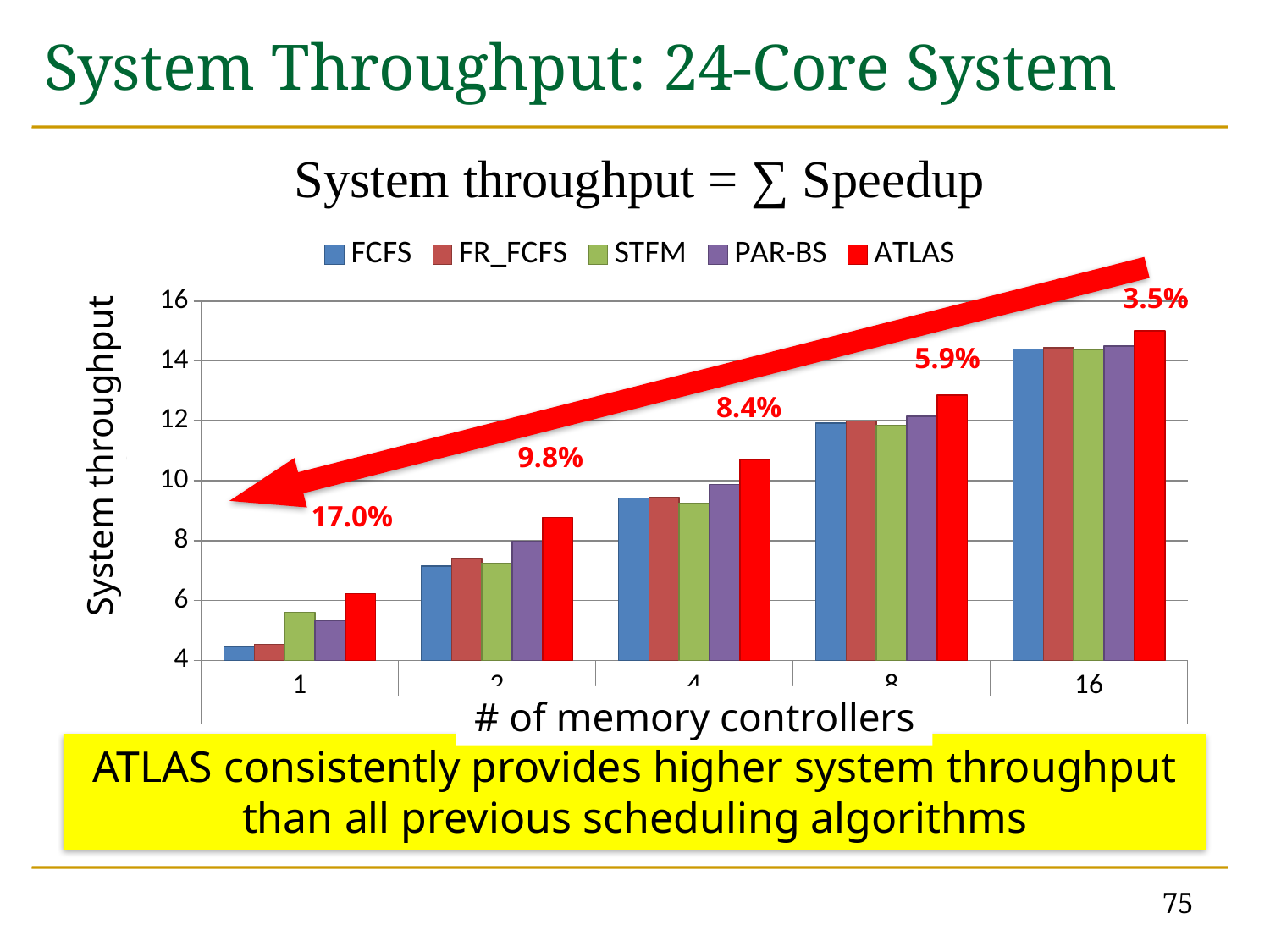
Which scheduling algorithm has the highest system throughput with 16 memory controllers? ATLAS With 2 memory controllers, which has higher system throughput: FCFS or ATLAS? ATLAS How many memory-controller configurations (categories) are shown on the x axis? 5 Is the ATLAS system throughput with 16 memory controllers greater or less than 14? greater Is the FCFS system throughput with 1 memory controller greater or less than 6? less Does ATLAS system throughput rise or fall as the number of memory controllers increases? rises What kind of chart is shown on the slide? bar chart Is the FCFS system throughput with 4 memory controllers greater or less than 10? less What is the label of the x axis? # of memory controllers How many series does the legend list? 5 What percentage improvement is annotated above the bars for 1 memory controller? 17.0% Which scheduling algorithm has the highest system throughput with 1 memory controller? ATLAS